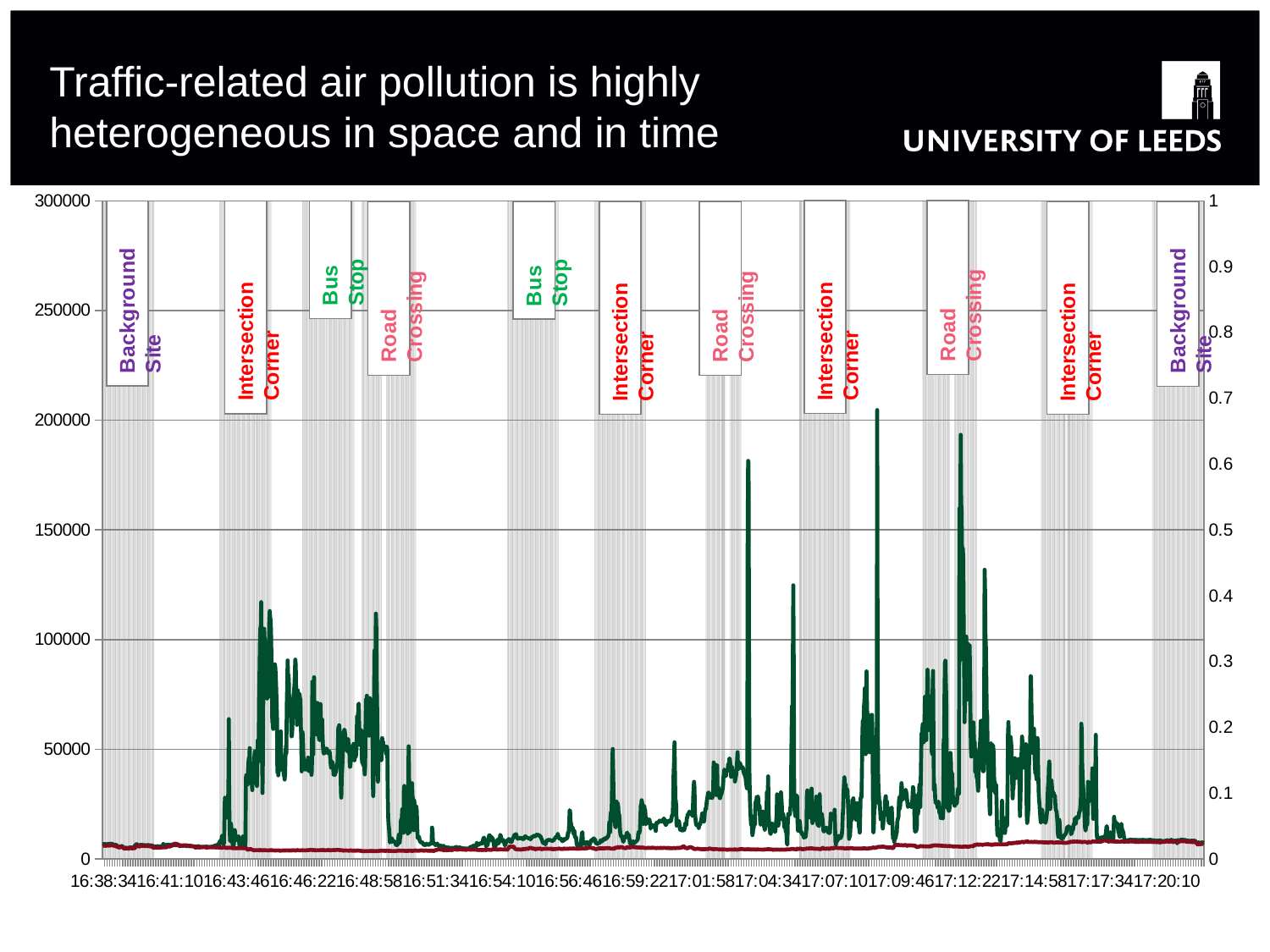
What is the maximum value shown on the left vertical axis of the chart? 300000 Does the dark red line ever rise above 50000 on the left axis? no Is the highest peak of the green line during the first Intersection Corner period greater or less than 100000 on the left axis? greater Is the highest peak of the green line greater or less than 150000 on the left axis? greater How many times does the label "Road Crossing" appear on the chart? 3 How many times does the label "Intersection Corner" appear on the chart? 4 What is the title of the slide containing the chart? Traffic-related air pollution is highly heterogeneous in space and in time How many times does the label "Background Site" appear on the chart? 2 Which line reaches higher values on the chart, the green line or the dark red line? the green line What kind of chart is shown on the slide? line chart